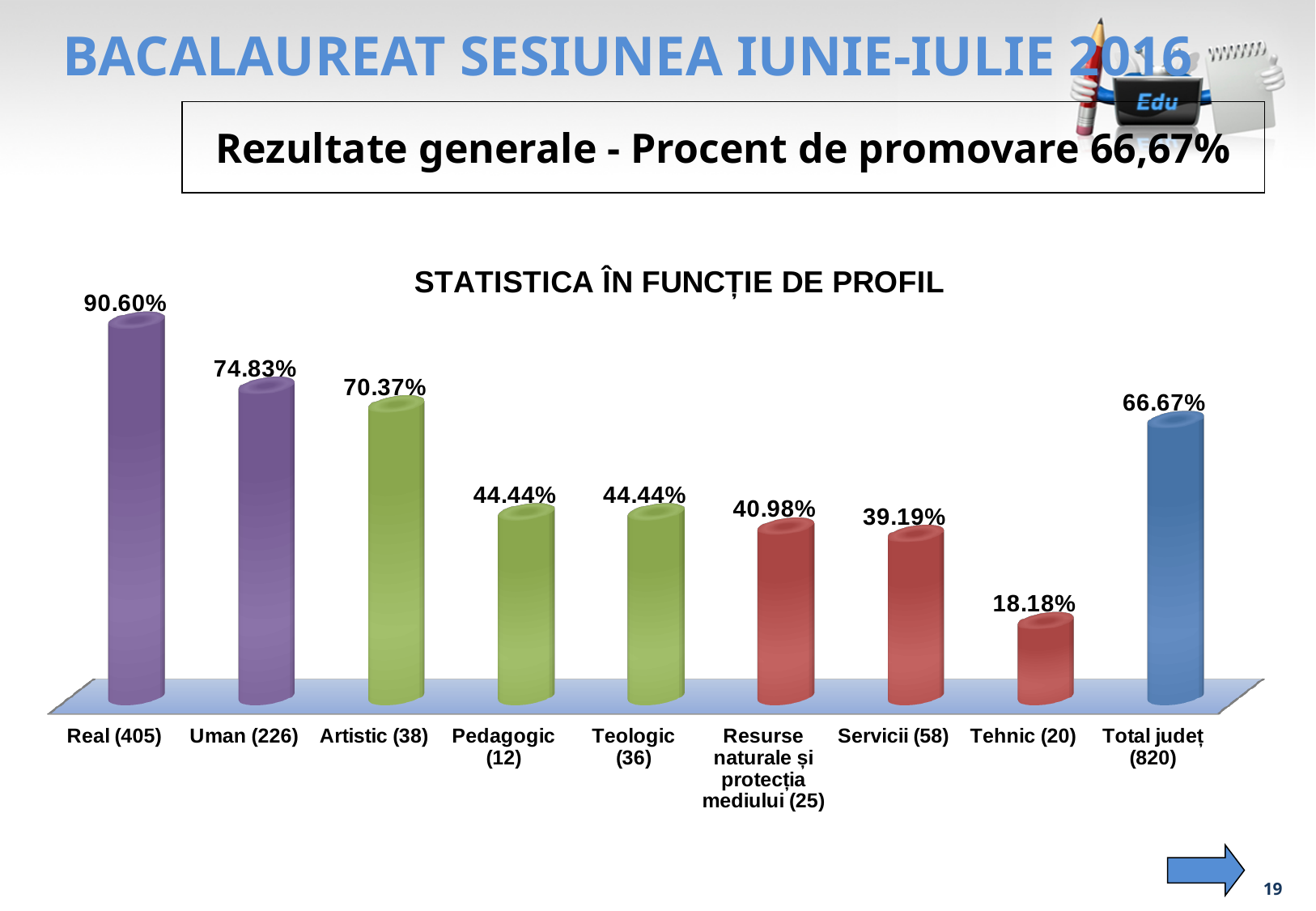
Which category has the lowest value? Tehnic (20) Which is larger, the value for Artistic (38) or the value for Total județ (820)? Artistic (38) What is the value for Servicii (58)? 39.19% How many categories are shown on the x axis? 9 What kind of chart is shown on the slide? Bar chart What is the difference between the values for Resurse naturale și protecția mediului (25) and Servicii (58)? 1.79% What is the value for Tehnic (20)? 18.18% What is the title of the chart? STATISTICA ÎN FUNCȚIE DE PROFIL What is the difference between the values for Real (405) and Uman (226)? 15.77% Which category has the highest value? Real (405) What is the value for Real (405)? 90.60% What is the value for Total județ (820)? 66.67%